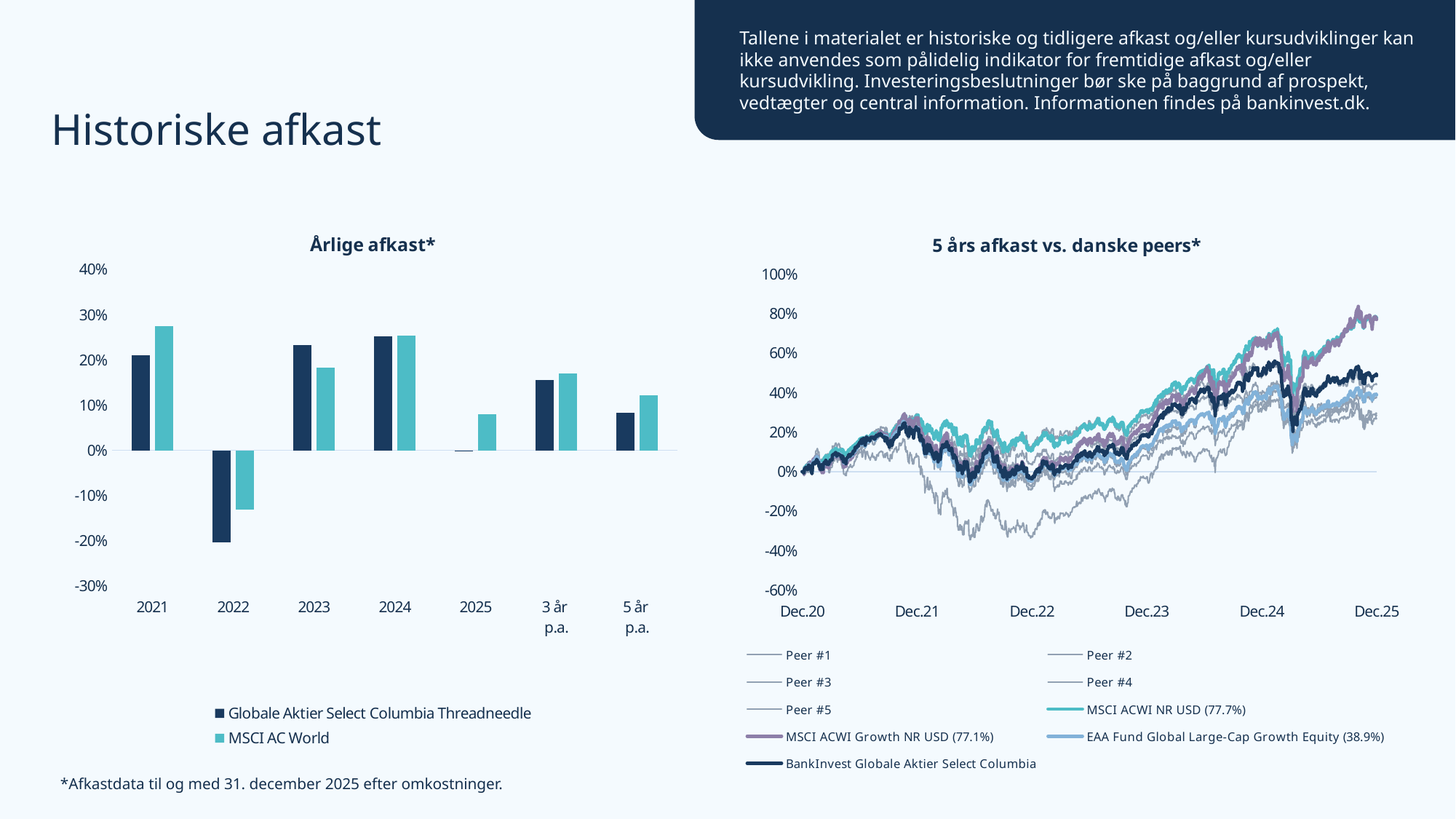
In the '5 års afkast vs. danske peers*' chart, what 5-year return is shown in the legend for EAA Fund Global Large-Cap Growth Equity? 38.9% In the 'Årlige afkast*' chart, how many series does the legend list? 2 In the '5 års afkast vs. danske peers*' chart, how many series does the legend list? 9 In the 'Årlige afkast*' chart, is the 2022 value for Globale Aktier Select Columbia Threadneedle greater or less than -10%? less In the 'Årlige afkast*' chart, what kind of chart is it? bar chart In the 'Årlige afkast*' chart, how many categories are shown on the x axis? 7 In the 'Årlige afkast*' chart, in which category is the value for Globale Aktier Select Columbia Threadneedle lowest? 2022 In the 'Årlige afkast*' chart, which series has the larger value in 2025? MSCI AC World In the 'Årlige afkast*' chart, which series has the larger value in 2023? Globale Aktier Select Columbia Threadneedle In the '5 års afkast vs. danske peers*' chart, what 5-year return is shown in the legend for MSCI ACWI NR USD? 77.7% In the '5 års afkast vs. danske peers*' chart, what kind of chart is it? line chart In the 'Årlige afkast*' chart, is the 2021 value for MSCI AC World greater or less than 20%? greater